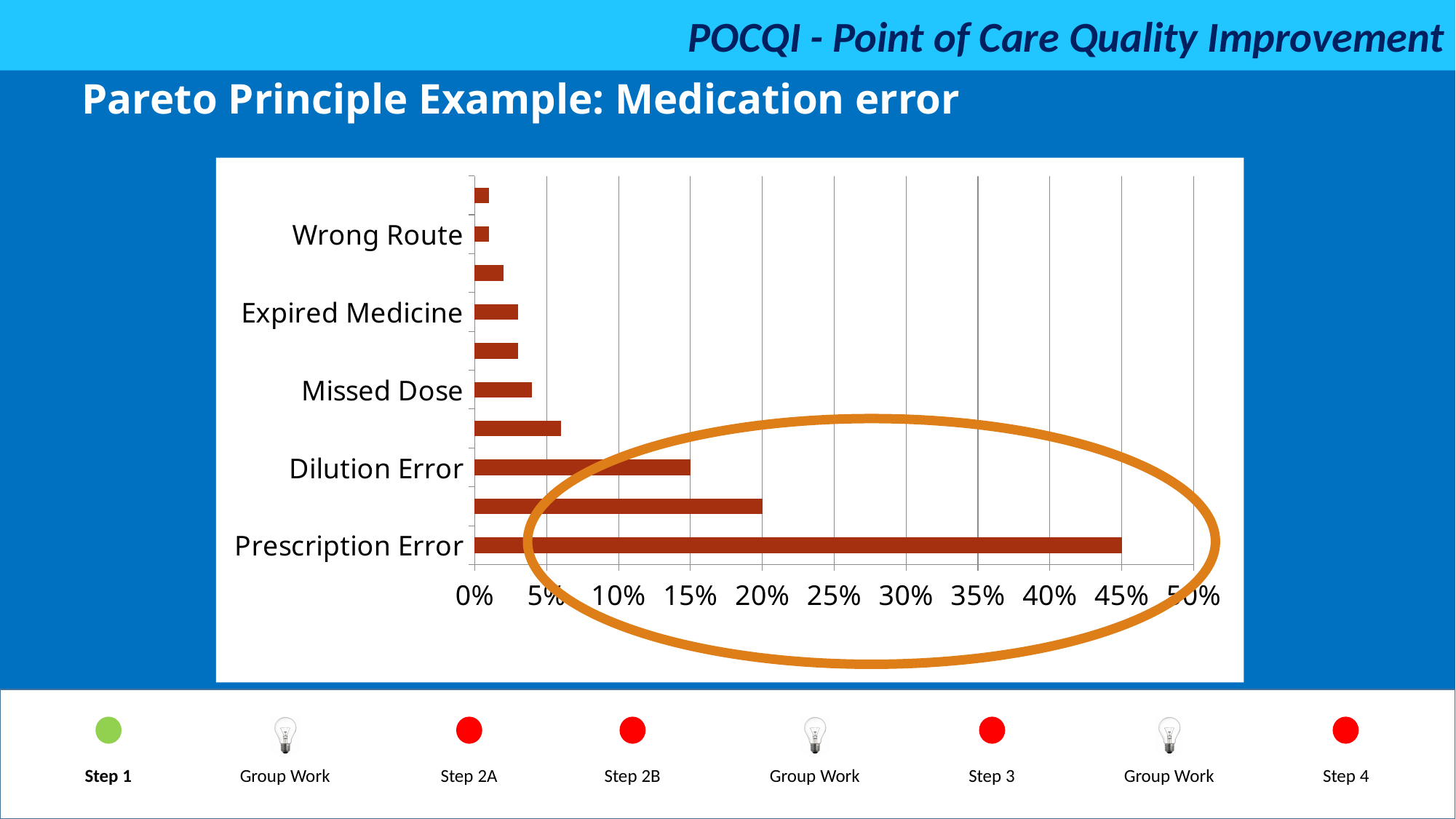
What is the difference between the values for Prescription Error and Dilution Error? 30% How many bars are plotted in the chart? 10 What is the highest value shown on the horizontal axis? 50% Which is larger, the value for Dilution Error or the value for Missed Dose? Dilution Error Do the bar values increase or decrease going from the top of the chart to the bottom? Increase What is the value for Prescription Error? 45% Is the value for Expired Medicine greater or less than 5%? less What type of chart is shown on the slide? Bar chart Is the value for Missed Dose greater or less than 5%? less Which is larger, the value for Prescription Error or the value for Dilution Error? Prescription Error What is the value for Dilution Error? 15% Which category has the highest value? Prescription Error